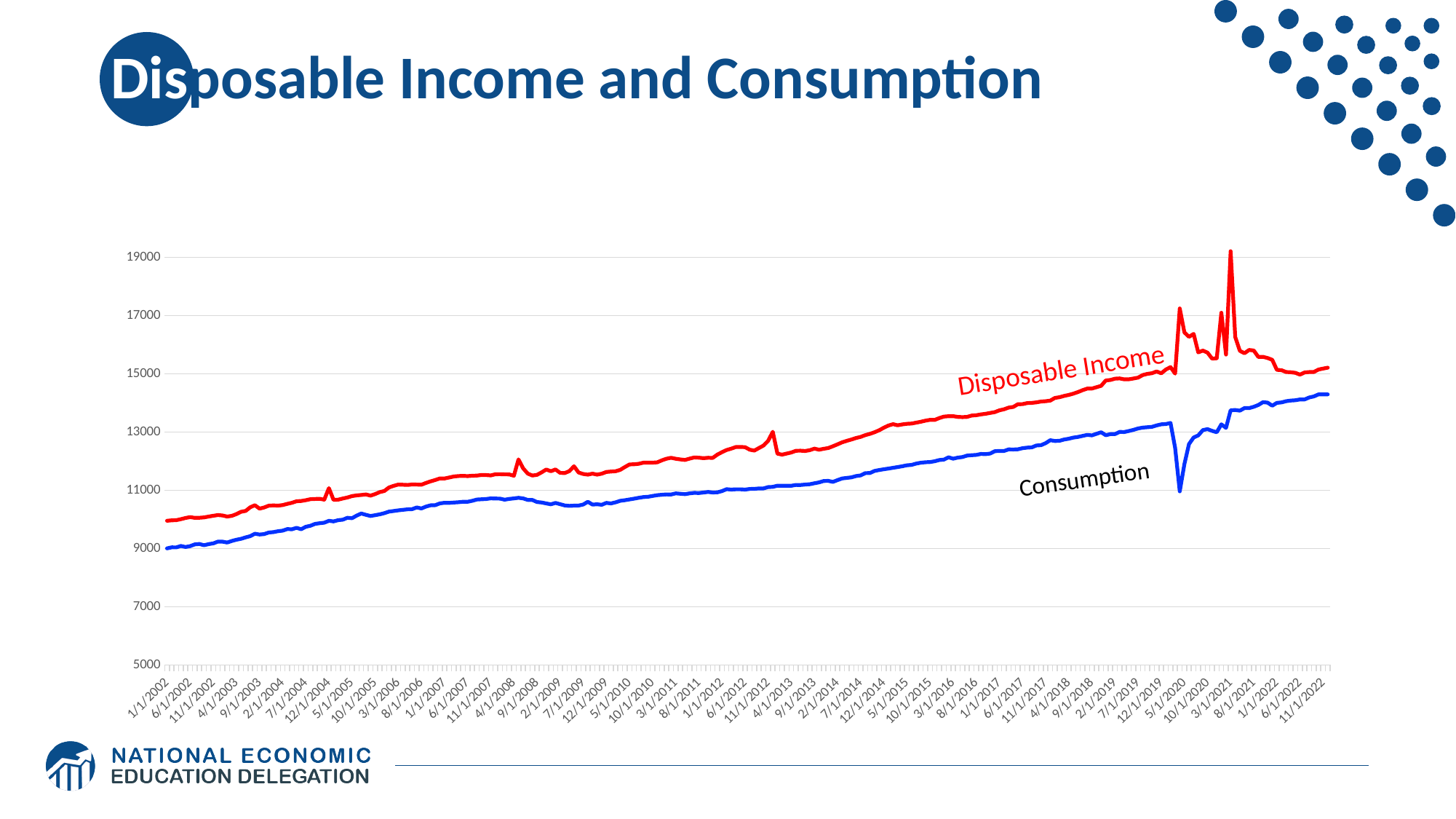
Is the peak value of Disposable Income around 2021 greater or less than 17000? greater Is the value for Disposable Income at 1/1/2002 greater or less than 11000? less Which series is higher throughout the chart, Disposable Income or Consumption? Disposable Income Is the value for Consumption at 11/1/2022 greater or less than 13000? greater What kind of chart is shown on the slide? line chart How many data series are plotted on the chart? 2 What is the title of the slide? Disposable Income and Consumption Do the Consumption values generally rise or fall from 1/1/2002 to 11/1/2022? rise Which series is drawn in red? Disposable Income Which series reaches the highest value on the chart? Disposable Income